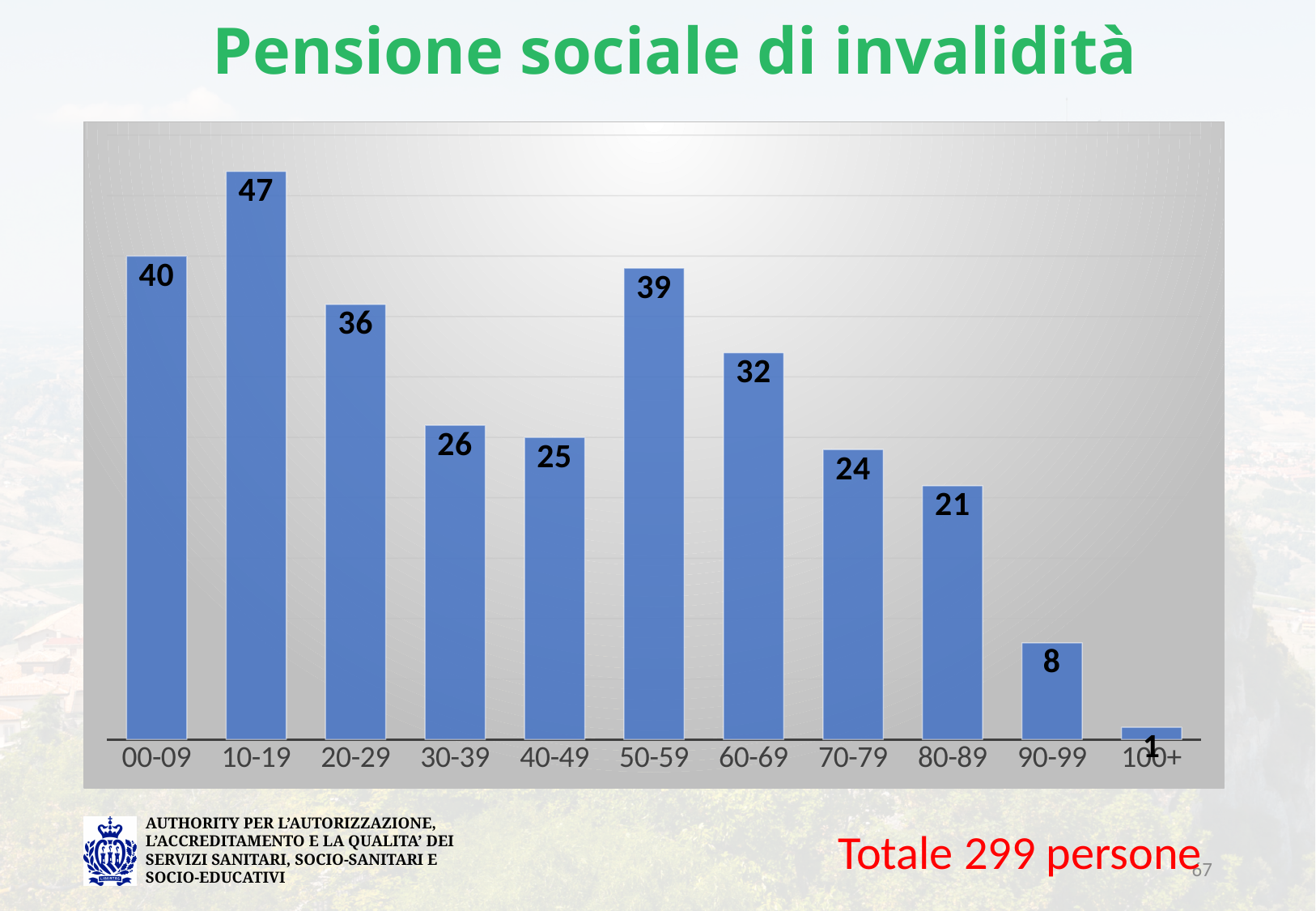
What is the difference between the values for 60-69 and 70-79? 8 What is the value for the 50-59 age group? 39 What is the value for the 10-19 age group? 47 What is the value for the 90-99 age group? 8 Which is larger, the value for 20-29 or the value for 50-59? 50-59 Which age group has the highest value? 10-19 Which is larger, the value for 30-39 or the value for 40-49? 30-39 What is the title of the slide? Pensione sociale di invalidità How many age groups are shown on the x axis? 11 Which age group has the lowest value? 100+ What kind of chart is shown on the slide? bar chart What is the difference between the values for 10-19 and 00-09? 7